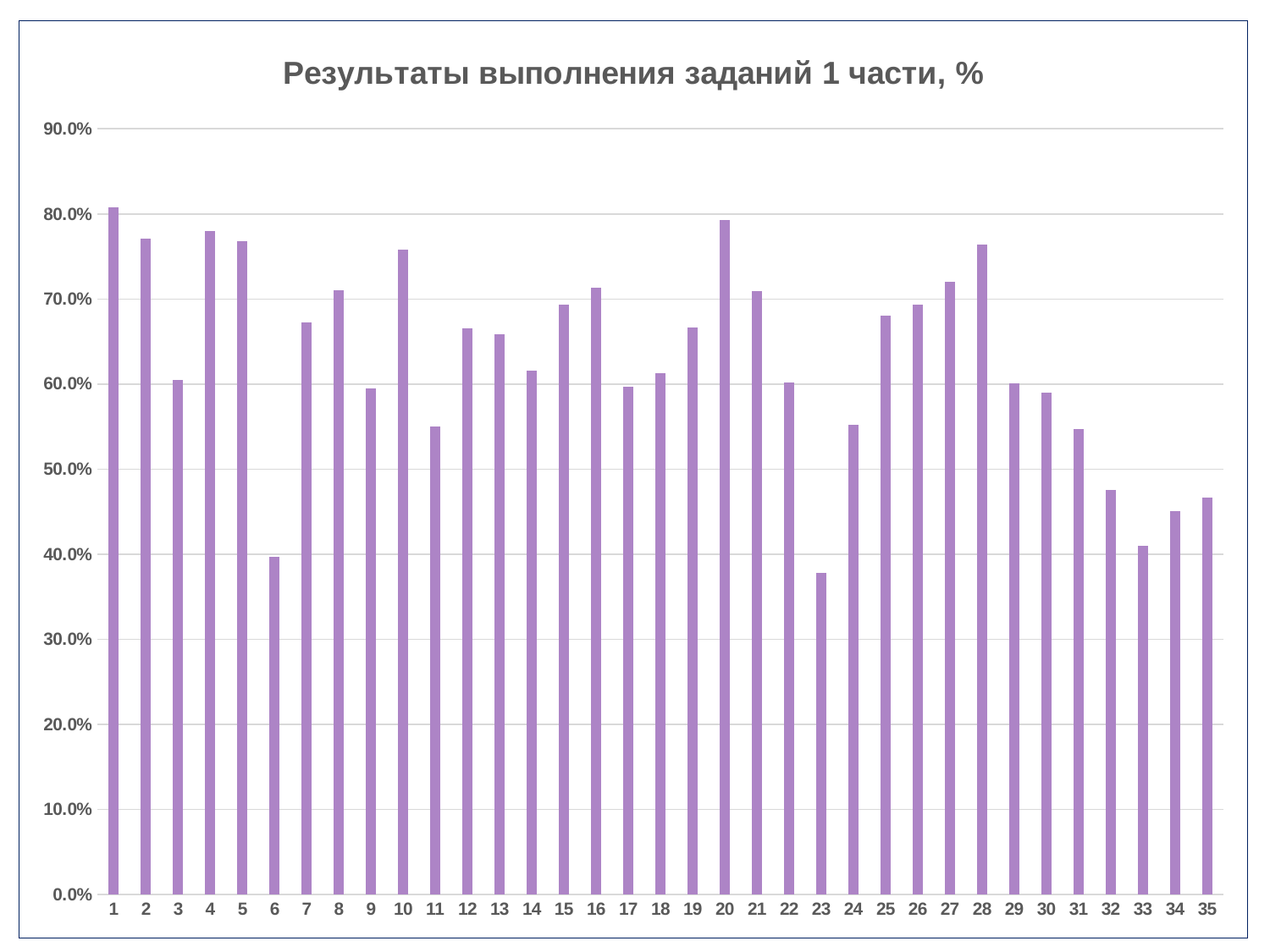
Is the value for task 10 greater or less than 70.0%? greater Is the value for task 33 greater or less than 50.0%? less Is the value for task 11 greater or less than 50.0%? greater Which task has the highest result? 1 How many tasks (categories) are plotted on the x axis? 35 Which task has the lowest result? 23 Which is larger, the value for task 4 or the value for task 3? task 4 What is the title of the chart? Результаты выполнения заданий 1 части, % What kind of chart is shown on the slide? bar chart Which is larger, the value for task 6 or the value for task 1? task 1